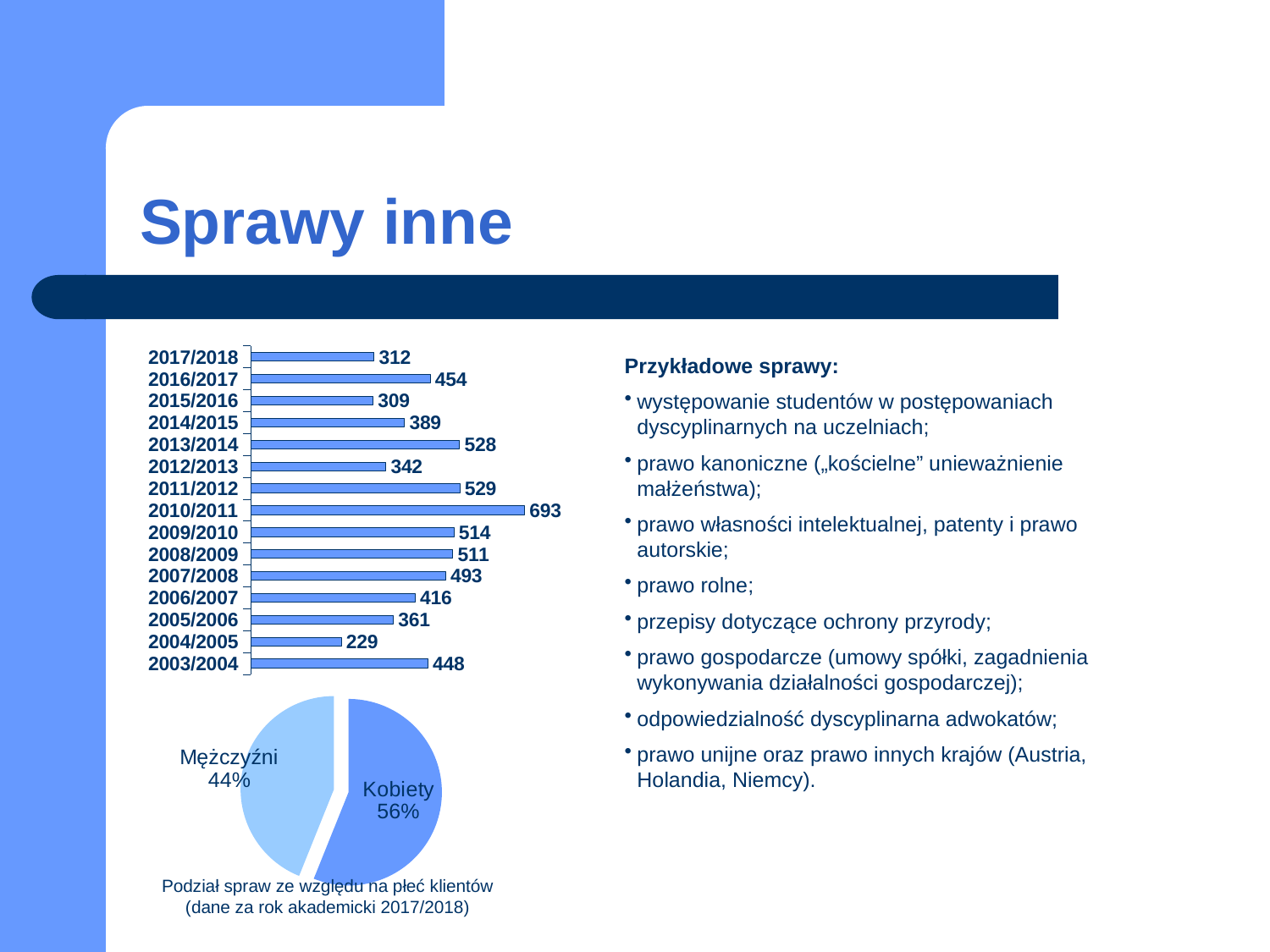
In the pie chart at the bottom left of the slide, what share is Mężczyźni? 44% In the bar chart at the top left of the slide, which year has the highest value? 2010/2011 In the pie chart at the bottom left of the slide, what share is Kobiety? 56% In the bar chart at the top left of the slide, what is the value for 2004/2005? 229 What kind of chart is the chart at the bottom left of the slide? pie chart In the bar chart at the top left of the slide, what is the value for 2017/2018? 312 How many years are shown in the bar chart at the top left of the slide? 15 What kind of chart is the chart at the top left of the slide? bar chart In the bar chart at the top left of the slide, what is the value for 2010/2011? 693 In the bar chart at the top left of the slide, which year has the lowest value? 2004/2005 In the bar chart at the top left of the slide, what is the difference between the values for 2016/2017 and 2015/2016? 145 In the bar chart at the top left of the slide, which is larger, the value for 2013/2014 or the value for 2012/2013? 2013/2014